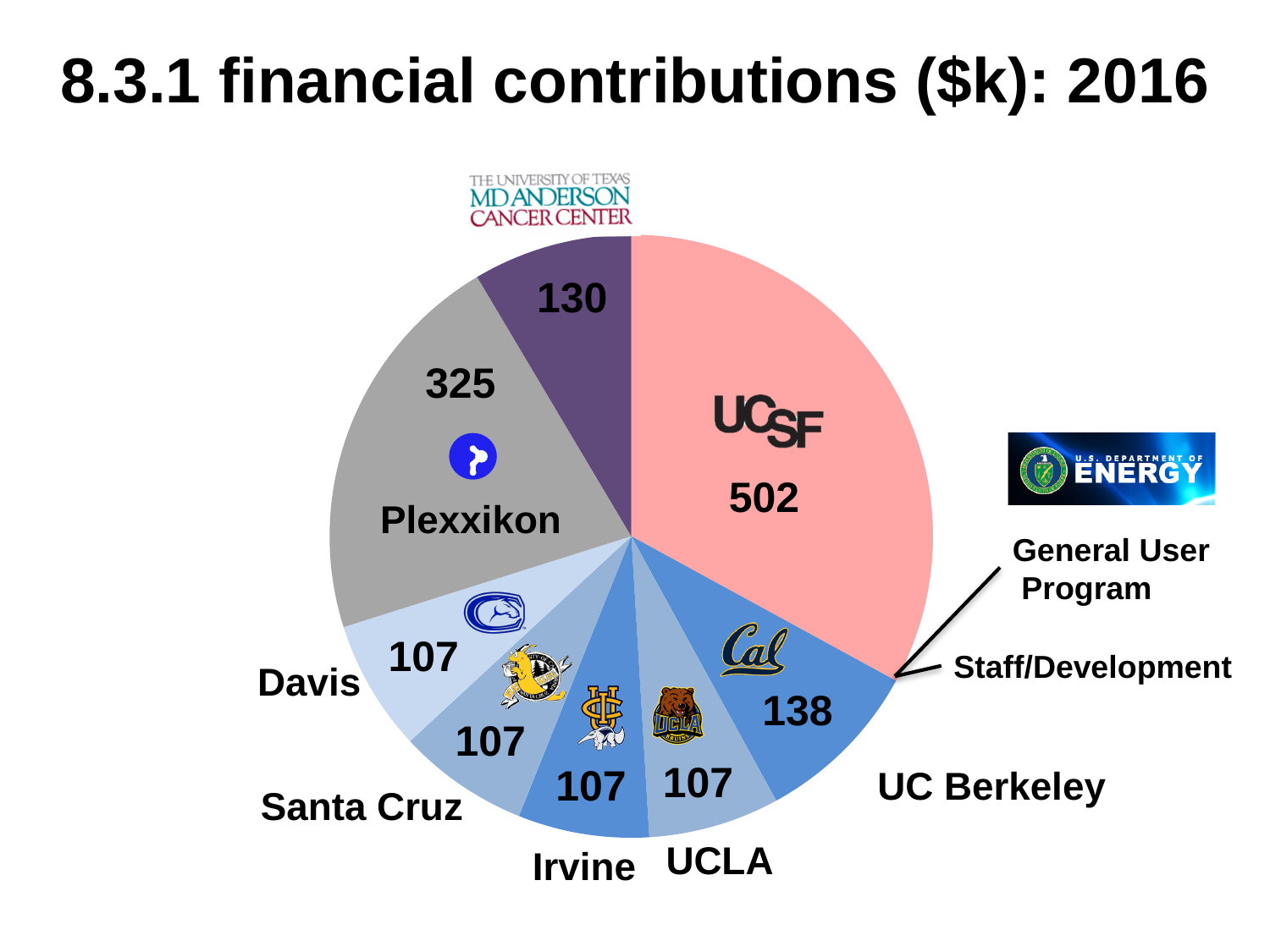
Which contributor has the largest slice of the pie? UCSF Which is larger, the contribution from Plexxikon or from UC Berkeley? Plexxikon What is the financial contribution from Santa Cruz? 107 What kind of chart is shown on the slide? pie chart Which is larger, the contribution from MD Anderson Cancer Center or from Davis? MD Anderson Cancer Center What is the difference between the UCSF and Plexxikon contributions? 177 What is the difference between the UC Berkeley and UCLA contributions? 31 What is the financial contribution from UCSF? 502 What is the financial contribution from Plexxikon? 325 What is the financial contribution from UC Berkeley? 138 What is the financial contribution from MD Anderson Cancer Center? 130 What is the title of the chart? 8.3.1 financial contributions ($k): 2016